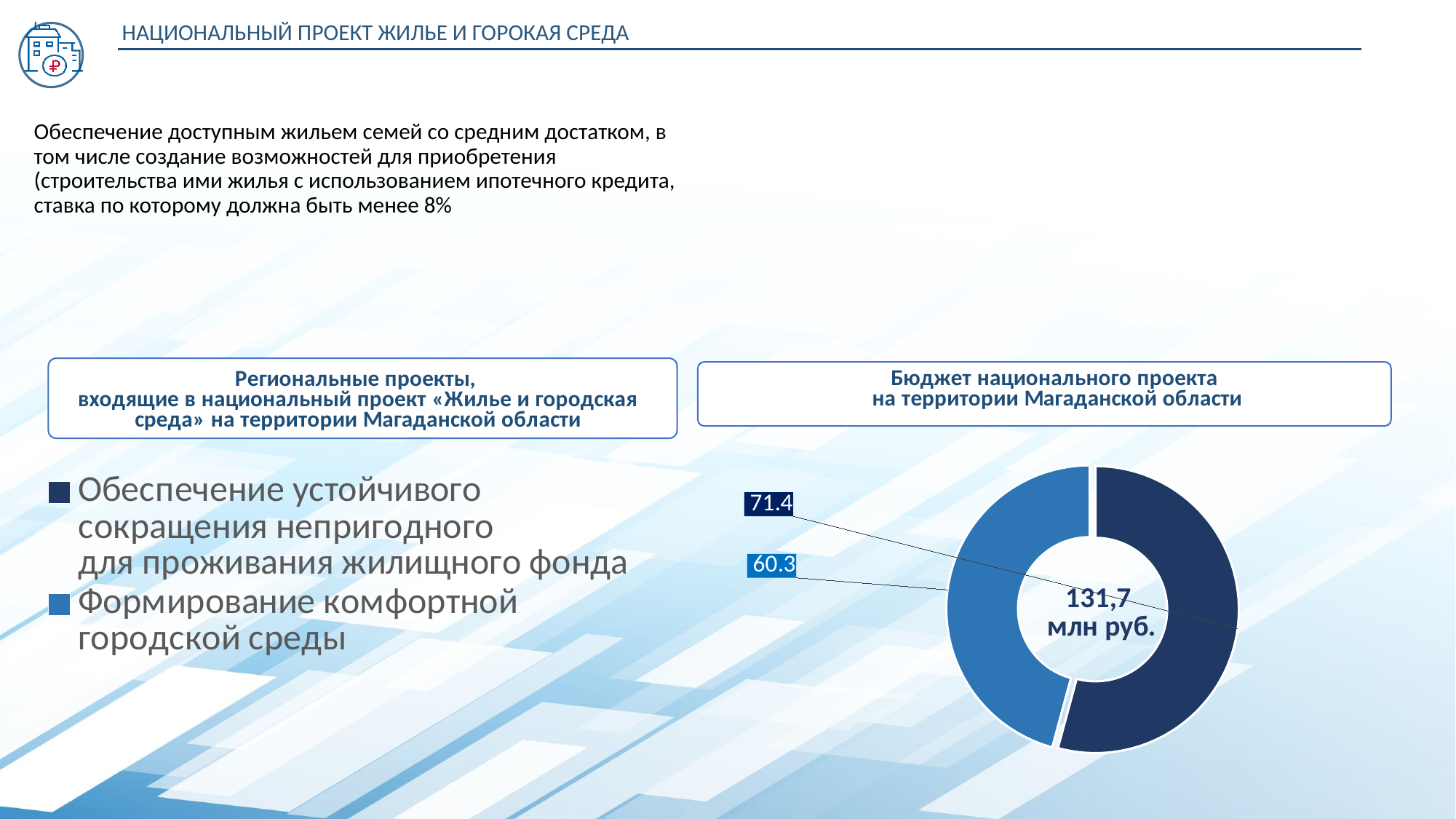
What kind of chart is shown under the heading «Бюджет национального проекта на территории Магаданской области»? Doughnut (pie) chart What is the difference between the two values shown in the doughnut chart (71.4 and 60.3)? 11.1 Which colour represents «Формирование комфортной городской среды» in the doughnut chart? Light blue Which is larger in the doughnut chart: the value for «Обеспечение устойчивого сокращения непригодного для проживания жилищного фонда» or for «Формирование комфортной городской среды»? Обеспечение устойчивого сокращения непригодного для проживания жилищного фонда What share of the total budget (131.7) does the 71.4 slice represent, to one decimal place? 54.2% What value is shown for «Обеспечение устойчивого сокращения непригодного для проживания жилищного фонда» in the doughnut chart? 71.4 What total budget is printed in the centre of the doughnut chart? 131,7 млн руб. What value is shown for «Формирование комфортной городской среды» in the doughnut chart? 60.3 Which regional project has the smallest slice in the doughnut chart? Формирование комфортной городской среды Which regional project has the largest slice in the doughnut chart? Обеспечение устойчивого сокращения непригодного для проживания жилищного фонда How many slices does the doughnut chart have? 2 How many entries does the legend of the doughnut chart list? 2